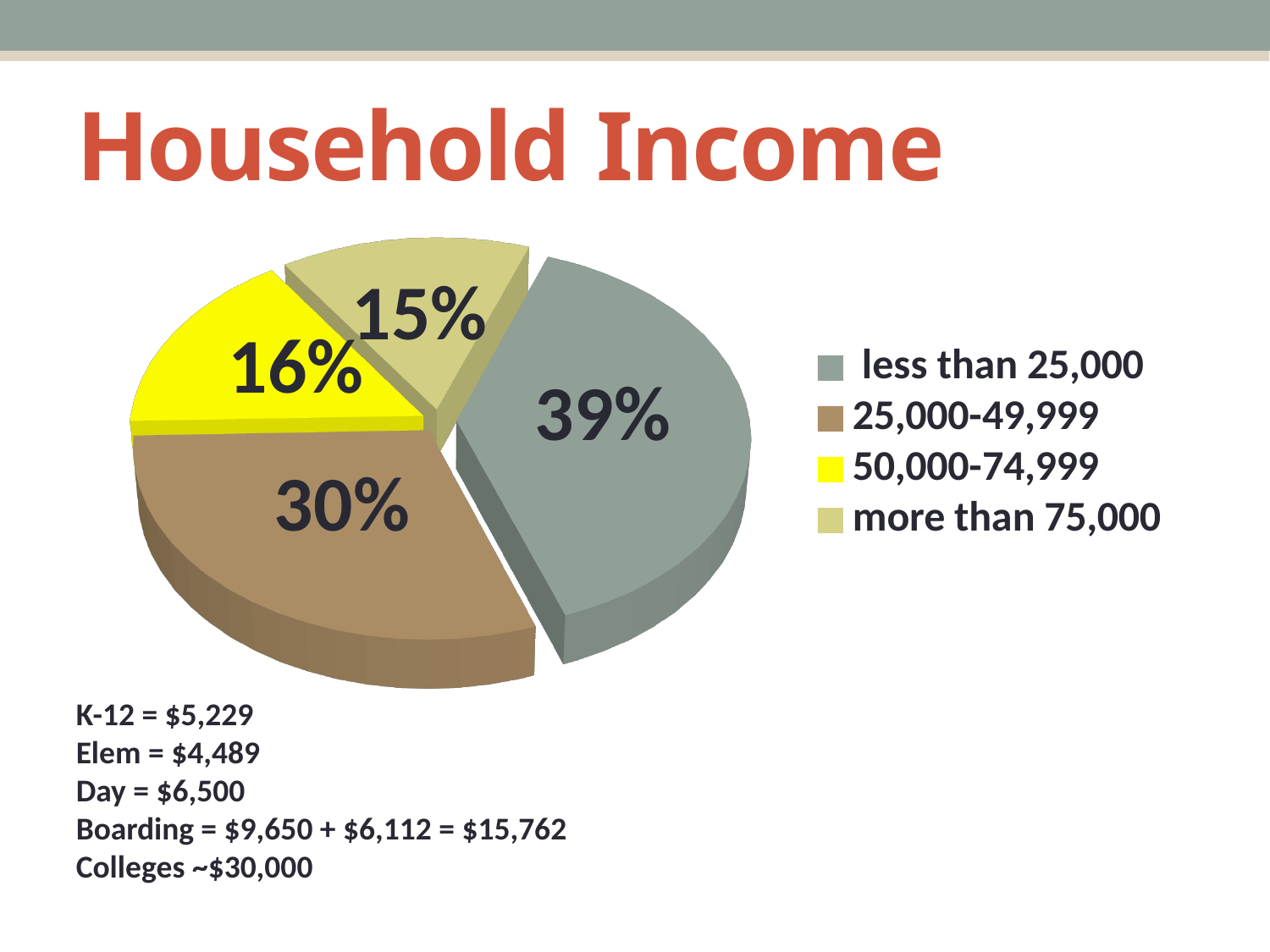
Which income category has the largest share of the pie? less than 25,000 What is the title of the slide containing the chart? Household Income What share of the pie is the '25,000-49,999' slice? 30% What share of the pie is the 'more than 75,000' slice? 15% What is the difference in percentage points between the 'less than 25,000' slice and the '25,000-49,999' slice? 9 Which income category is shown in yellow in the pie chart? 50,000-74,999 How many slices does the pie chart have? 4 What share of the pie is the 'less than 25,000' slice? 39% What kind of chart is shown on the slide? pie chart Which is larger: the share for '25,000-49,999' or the share for '50,000-74,999'? 25,000-49,999 Which income category has the smallest share of the pie? more than 75,000 What share of the pie is the '50,000-74,999' slice? 16%